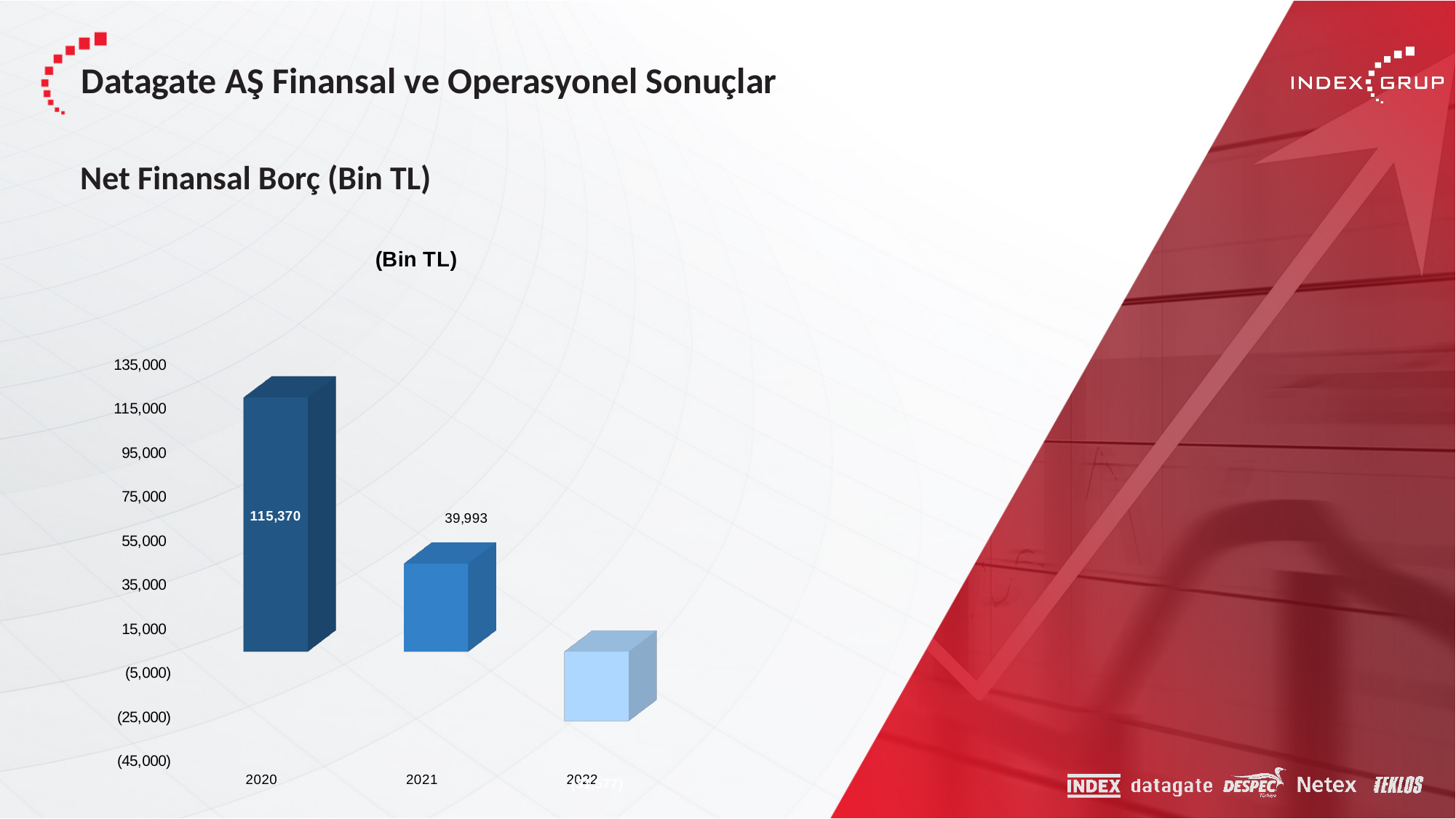
What kind of chart is shown on the slide? bar chart Is the value for 2022 greater or less than 15,000? less What is the heading above the chart on the slide? Net Finansal Borç (Bin TL) What is the value for 2020 in the (Bin TL) chart? 115,370 Which year has the lowest value in the chart? 2022 Do the values rise or fall from 2020 to 2022? fall What is the value for 2021 in the (Bin TL) chart? 39,993 Is the value for 2021 greater or less than 35,000? greater What is the difference between the values for 2020 and 2021? 75,377 Which is larger, the value for 2020 or the value for 2021? 2020 Which year has the highest value in the chart? 2020 How many years are shown on the x axis of the chart? 3